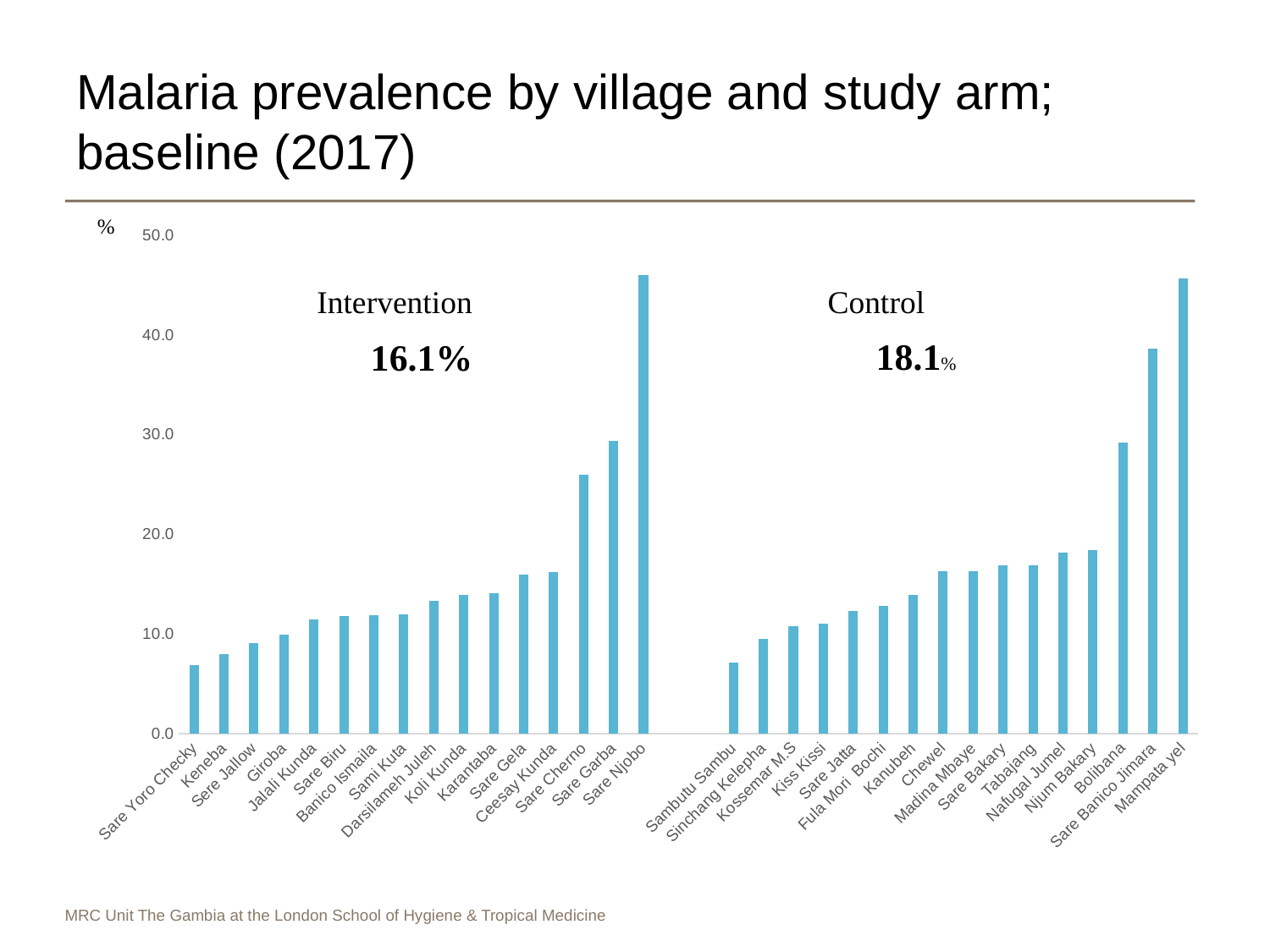
Is the value for Sare Cherno greater or less than 20.0? greater Which village in the Intervention arm has the highest malaria prevalence? Sare Njobo Which village in the Control arm has the lowest malaria prevalence? Sambutu Sambu Is the value for Sare Njobo greater or less than 40.0? greater What kind of chart is shown on the slide? Bar chart Is the value for Sambutu Sambu greater or less than 10.0? less Which village in the Control arm has the highest malaria prevalence? Mampata yel Which has the higher malaria prevalence, Sare Cherno or Sare Garba? Sare Garba How many villages are plotted in the Intervention arm? 16 How many villages are plotted in the Control arm? 16 What overall malaria prevalence is shown for the Control arm? 18.1% Which village in the Intervention arm has the lowest malaria prevalence? Sare Yoro Checky